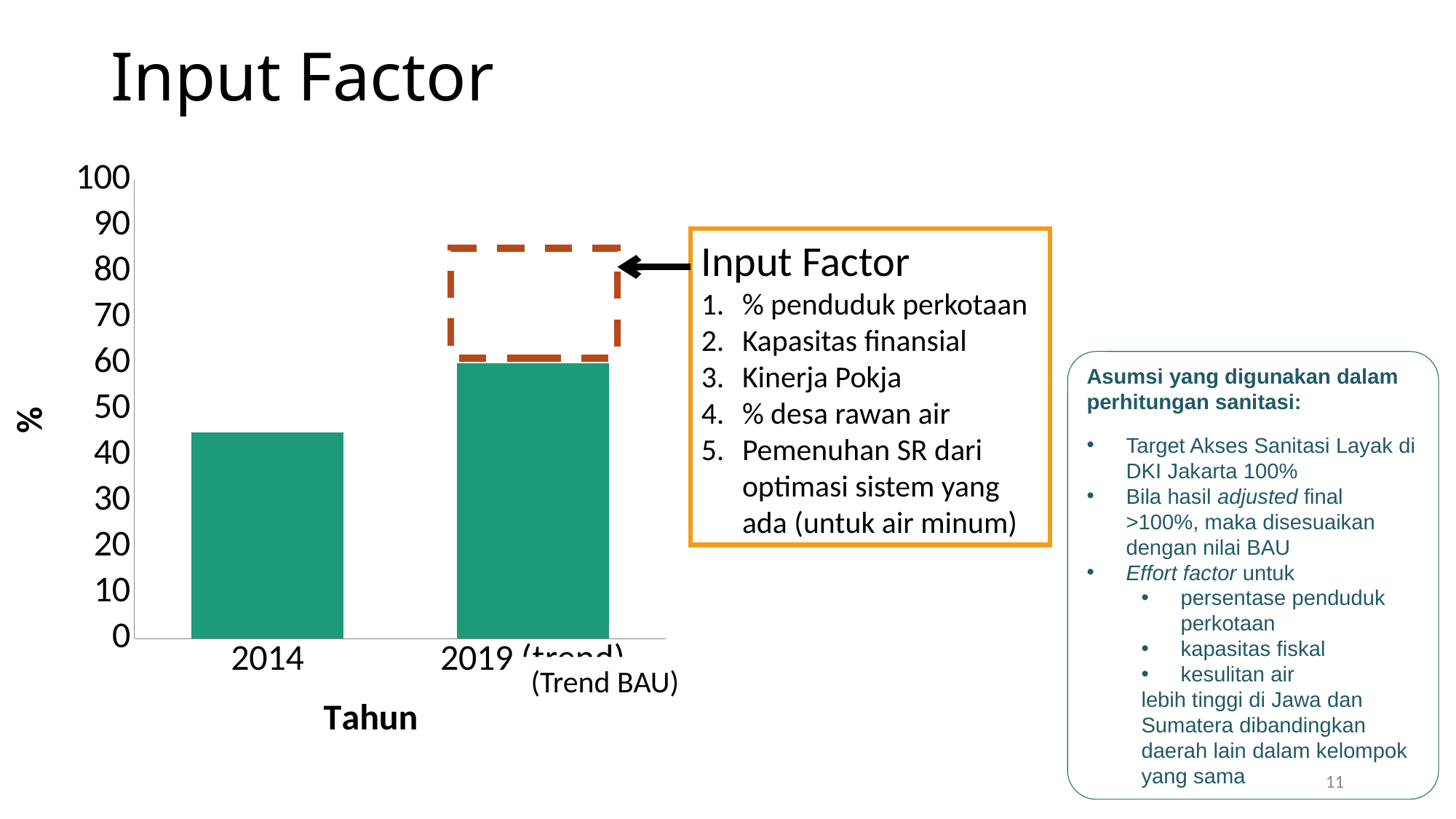
What is the label of the x axis of the chart? Tahun What is the label of the y axis of the chart? % Which year has the higher bar, 2014 or 2019 (trend)? 2019 (trend) Is the value for 2014 greater or less than 50? less What kind of chart is shown on the slide? bar chart Is the value for 2019 (trend) greater or less than 50? greater Is the value for 2014 greater or less than 40? greater Do the values rise or fall from 2014 to 2019 (trend)? rise How many bars are plotted in the chart? 2 Which category has the lowest value in the chart? 2014 Which category has the highest value in the chart? 2019 (trend)